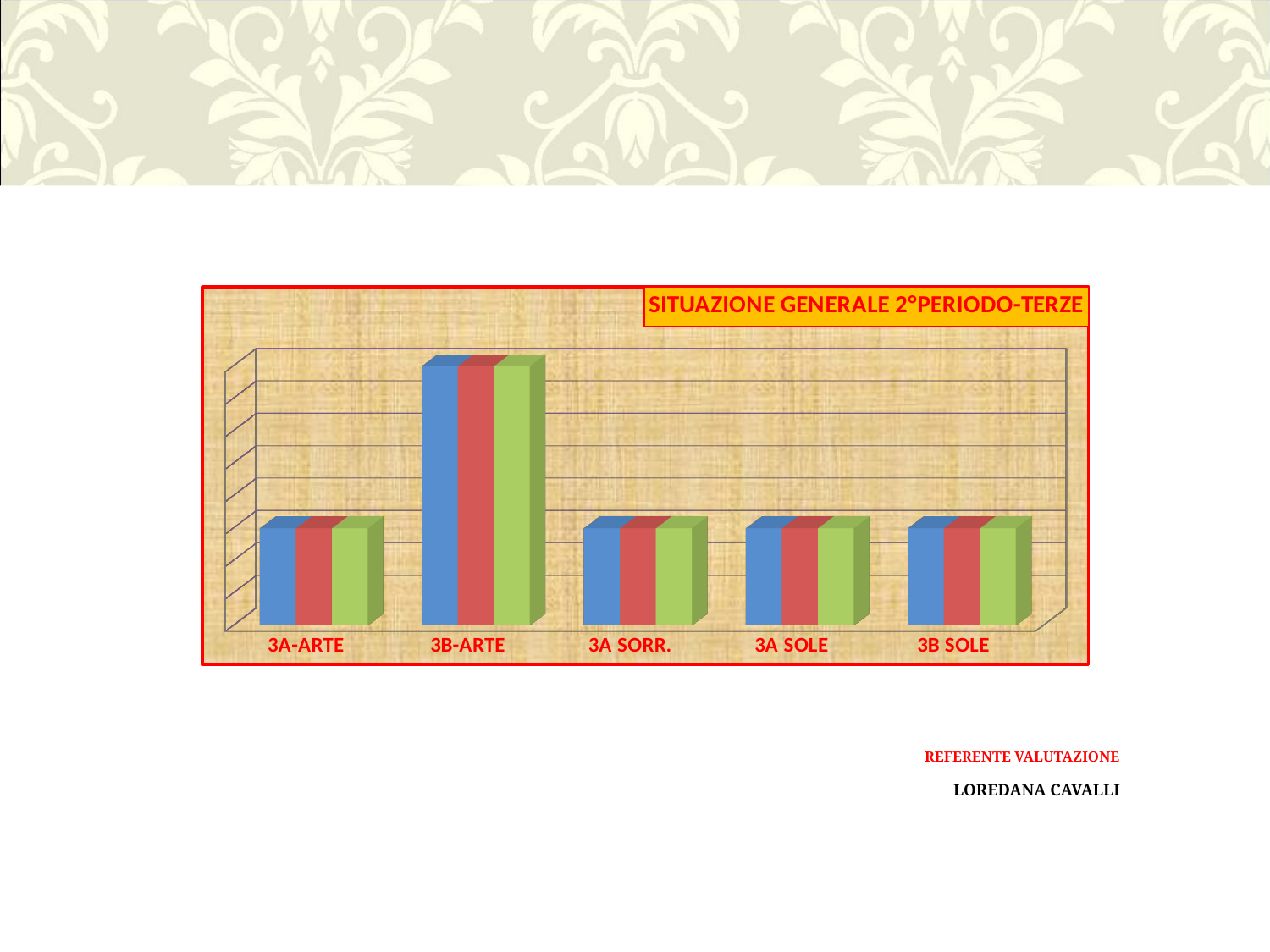
How many categories are shown on the x axis of the chart? 5 Which category has taller bars, 3B SOLE or 3B-ARTE? 3B-ARTE What is the label of the first category on the x axis? 3A-ARTE What colours are the three bars in each category group? Blue, red and green What type of chart is shown on the slide? Bar chart How many bars are plotted for each category in the chart? 3 Which category has the highest bars in the chart? 3B-ARTE What is the label of the last category on the x axis? 3B SOLE Which category has taller bars, 3A-ARTE or 3B-ARTE? 3B-ARTE What is the title of the chart? SITUAZIONE GENERALE 2°PERIODO-TERZE